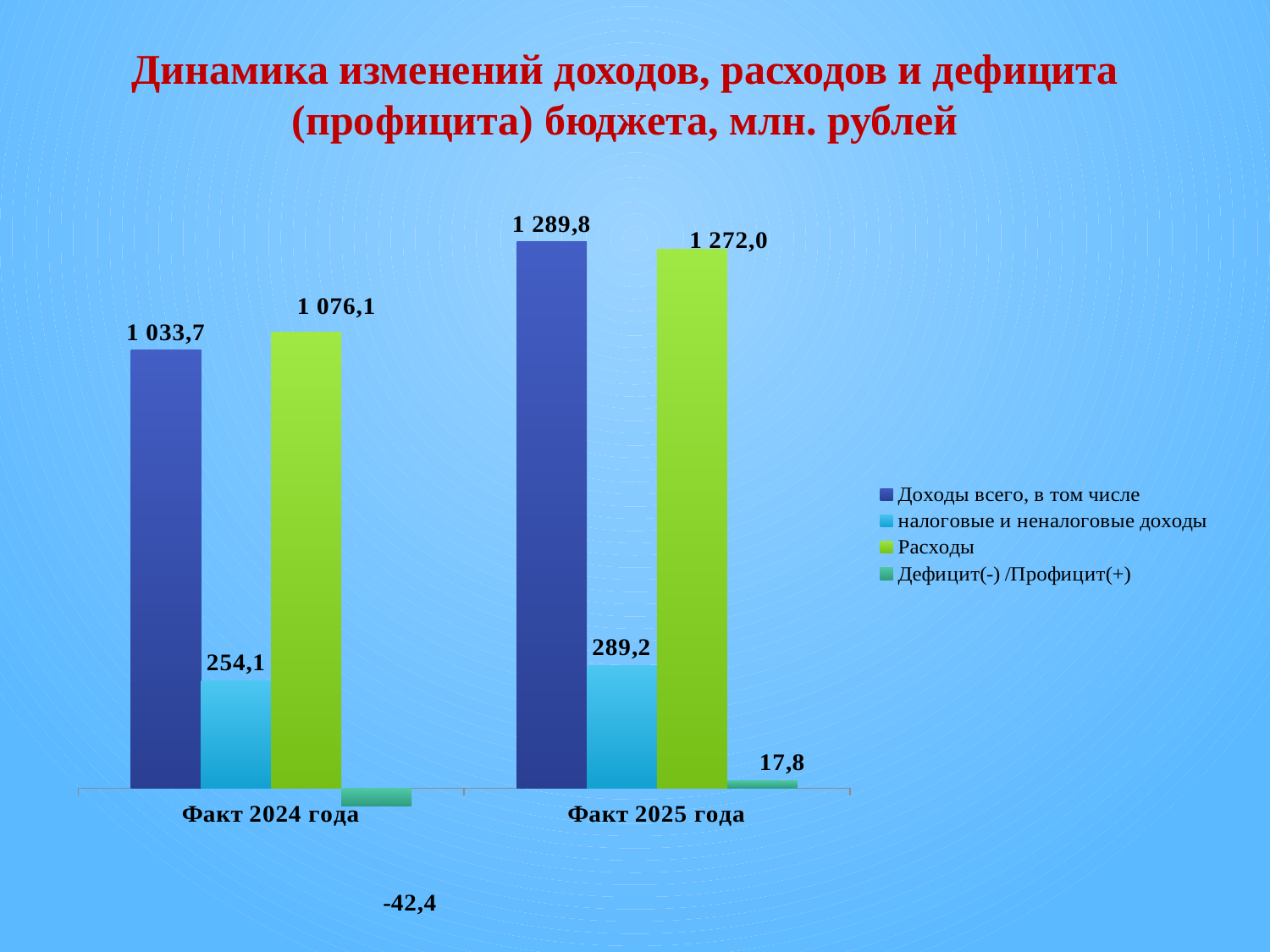
What is the difference between Доходы всего for Факт 2025 года and Факт 2024 года? 256,1 What is the value of Расходы for Факт 2025 года? 1 272,0 Which is larger for Факт 2025 года: Доходы всего or Расходы? Доходы всего What is the value of налоговые и неналоговые доходы for Факт 2025 года? 289,2 What kind of chart is shown on the slide? Bar chart What is the value of Доходы всего for Факт 2024 года? 1 033,7 What is the value of Дефицит(-) /Профицит(+) for Факт 2025 года? 17,8 How many series does the legend list? 4 Which series has the highest value for Факт 2024 года? Расходы What is the value of Дефицит(-) /Профицит(+) for Факт 2024 года? -42,4 How many categories are shown on the x axis? 2 Which series has the lowest value for Факт 2025 года? Дефицит(-) /Профицит(+)